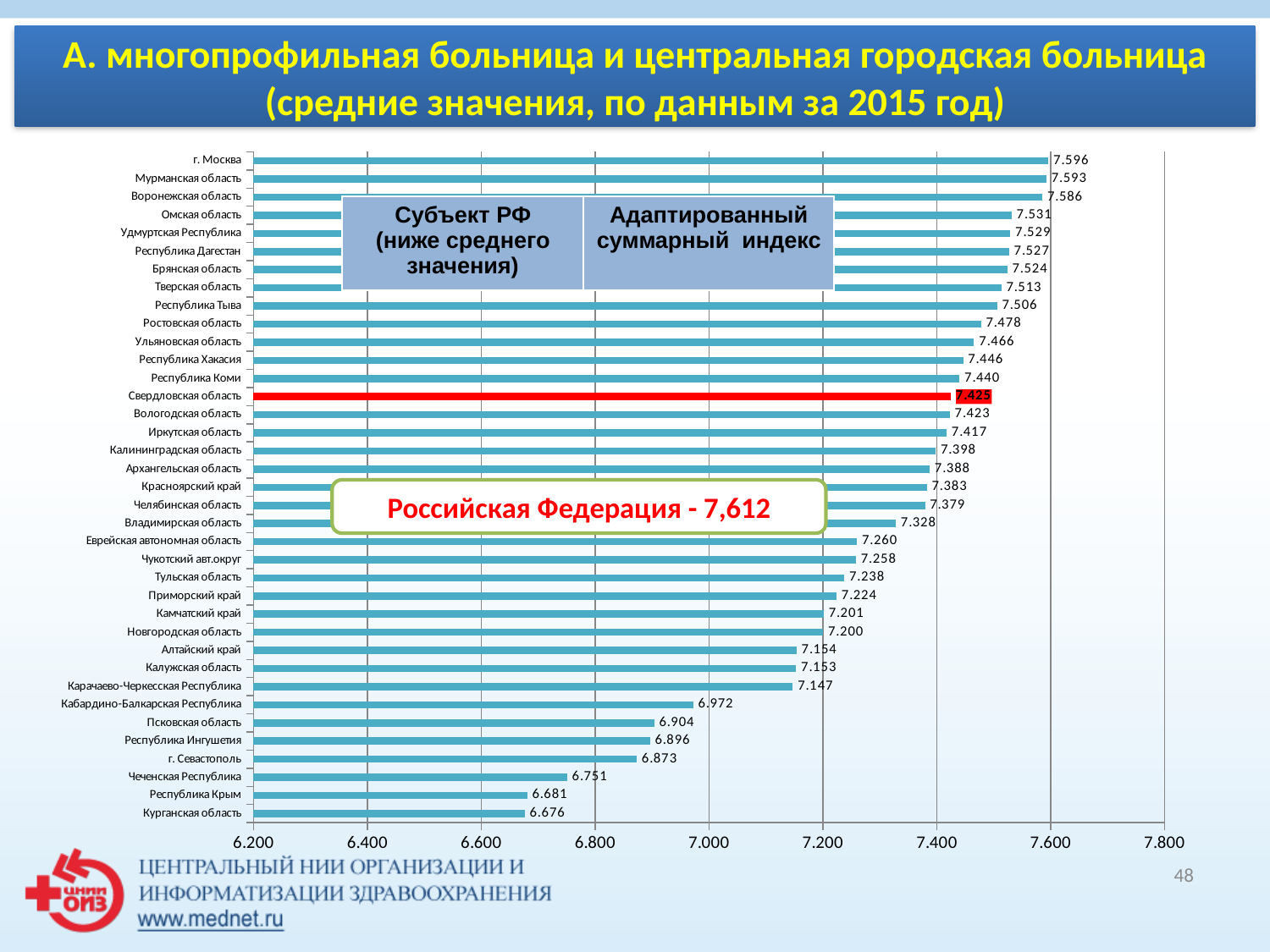
What is the value for Свердловская область? 7.425 What is the value for Республика Крым? 6.681 What is the value for г. Москва? 7.596 What value is given for Российская Федерация in the callout box on the chart? 7,612 Is the value for Кабардино-Балкарская Республика greater or less than 7.000? less Which has a larger value, Псковская область or Чеченская Республика? Псковская область Which region has the lowest value? Курганская область Which region's bar is highlighted in red? Свердловская область What is the difference between the values for г. Москва and Курганская область? 0.920 How many regions are plotted in the chart? 37 Which region has the highest value? г. Москва What type of chart is shown on the slide? bar chart